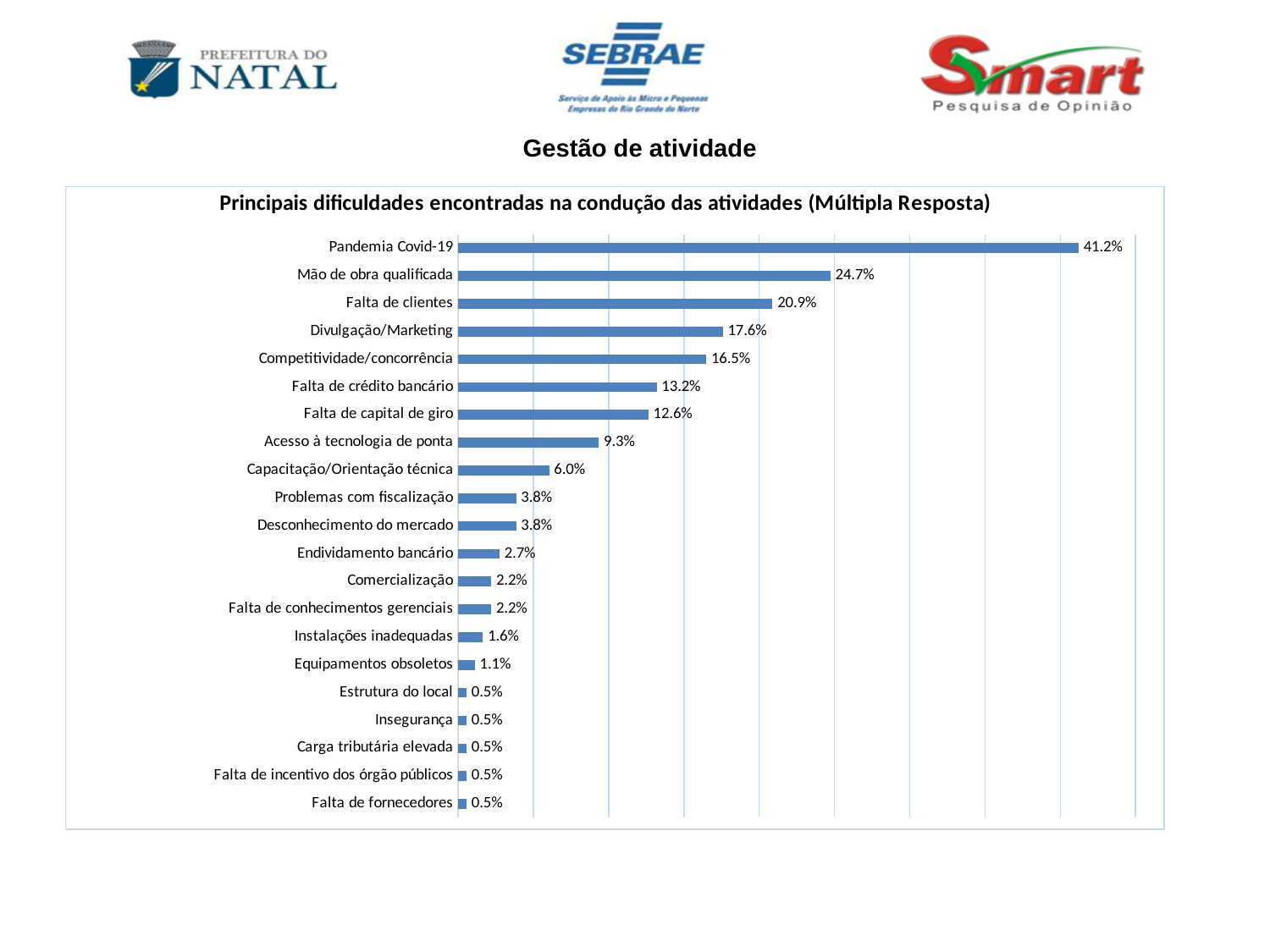
What is the value for Equipamentos obsoletos? 1.1% What kind of chart is shown on the slide? Bar chart Which is larger, Divulgação/Marketing or Competitividade/concorrência? Divulgação/Marketing Which is larger, Falta de crédito bancário or Falta de capital de giro? Falta de crédito bancário How many categories are shown in the chart? 21 What is the difference between Pandemia Covid-19 and Mão de obra qualificada? 16.5% What is the title of the chart? Principais dificuldades encontradas na condução das atividades (Múltipla Resposta) What is the value for Falta de clientes? 20.9% What is the value for Pandemia Covid-19? 41.2% What is the value for Acesso à tecnologia de ponta? 9.3% What is the difference between Mão de obra qualificada and Falta de clientes? 3.8% Which category has the highest value? Pandemia Covid-19